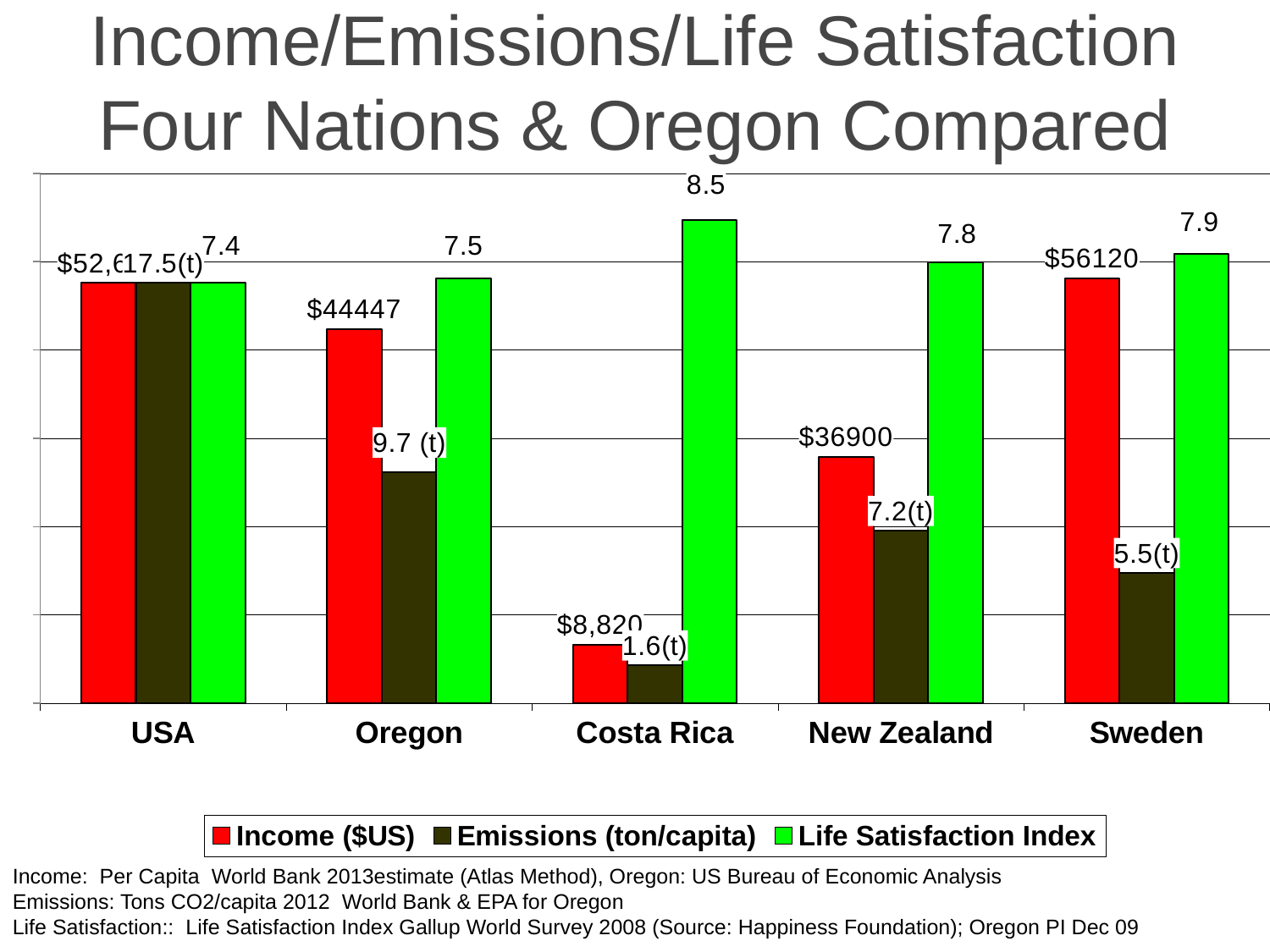
Which has higher Emissions (ton/capita), Oregon or New Zealand? Oregon How many series does the legend list? 3 What kind of chart is shown on the slide? Bar chart Which category has the lowest Income ($US)? Costa Rica Which category has the highest Emissions (ton/capita)? USA What is the Life Satisfaction Index value for Costa Rica? 8.5 What is the Income ($US) value shown for Oregon? $44447 What is the Emissions (ton/capita) value shown for Sweden? 5.5(t) How many categories are shown on the x axis? 5 Which category has the highest Life Satisfaction Index? Costa Rica How much higher is Sweden's Income ($US) than New Zealand's? $19220 What is the Life Satisfaction Index value for New Zealand? 7.8